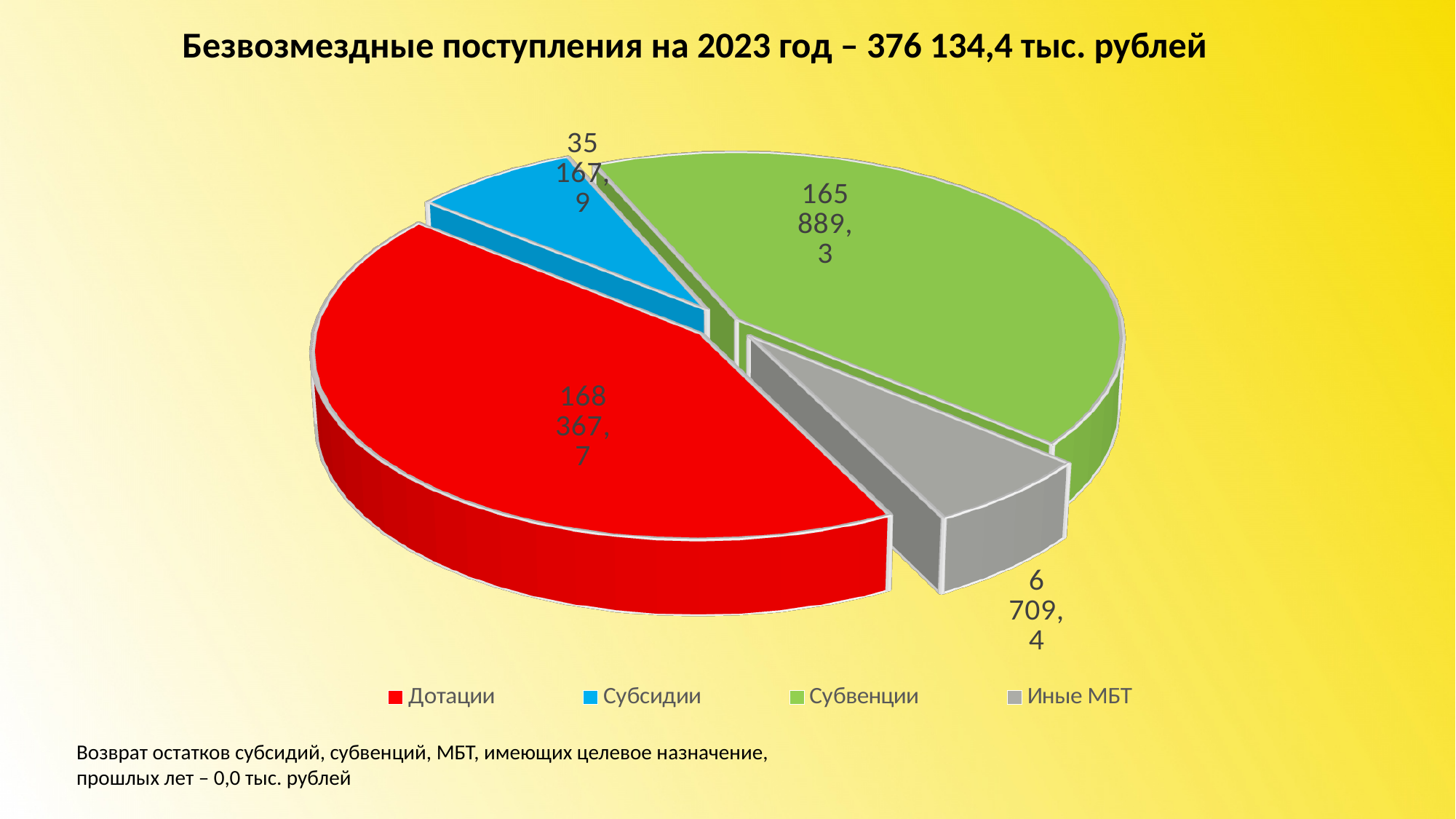
What is the difference between Субсидии and Иные МБТ? 28 458,5 Which is larger, Субсидии or Иные МБТ? Субсидии Which category has the smallest slice? Иные МБТ What is the difference between Субвенции and Субсидии? 130 721,4 What is the value for Дотации? 168 367,7 What is the value for Субсидии? 35 167,9 How many slices does the pie chart have? 4 What is the value for Субвенции? 165 889,3 What is the value for Иные МБТ? 6 709,4 Which category has the largest slice? Дотации What colour is the Субвенции slice? Green What kind of chart is shown on the slide? Pie chart